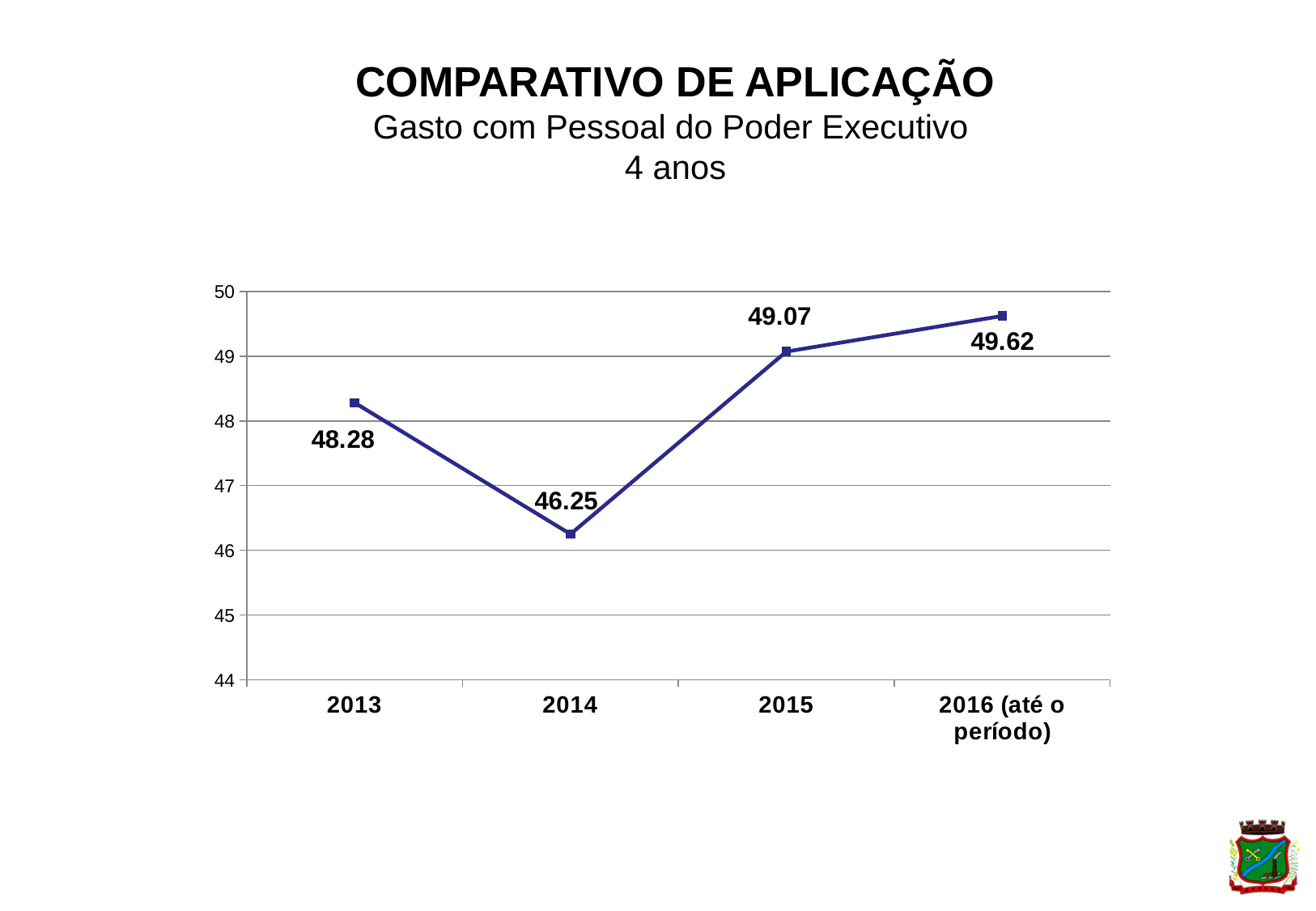
Is the value for 2014 greater or less than 47? less Which year has the highest value? 2016 (até o período) What is the value for 2015? 49.07 What kind of chart is shown on the slide? line chart Which year has the lowest value? 2014 What is the value for 2014? 46.25 What is the value for 2013? 48.28 What is the value for 2016 (até o período)? 49.62 How many data points are plotted on the chart? 4 Which is larger, the value for 2013 or the value for 2015? 2015 What is the difference between the values for 2016 (até o período) and 2013? 1.34 What is the difference between the values for 2015 and 2014? 2.82